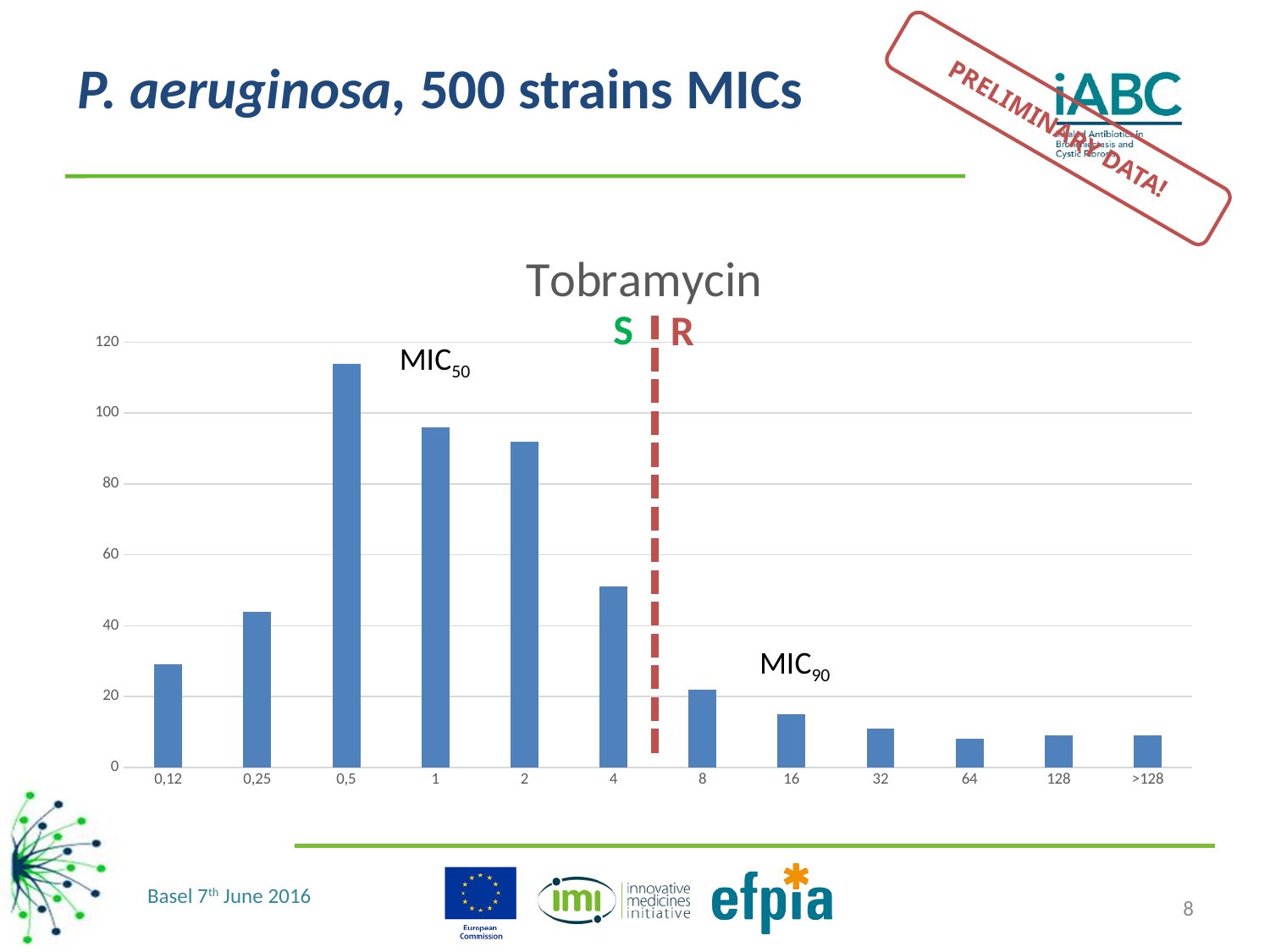
How many MIC categories are shown on the x axis? 12 Which has more strains, MIC 4 or MIC 8? 4 Is the value for 2 greater or less than 80? greater Is the value for 1 greater or less than 100? less Is the value for 16 greater or less than 20? less What is the title of the chart? Tobramycin What kind of chart is shown on the slide? bar chart Do the values rise or fall along the x axis from 0,5 to >128? fall Which has more strains, MIC 0,5 or MIC 1? 0,5 Which MIC category has the highest number of strains? 0,5